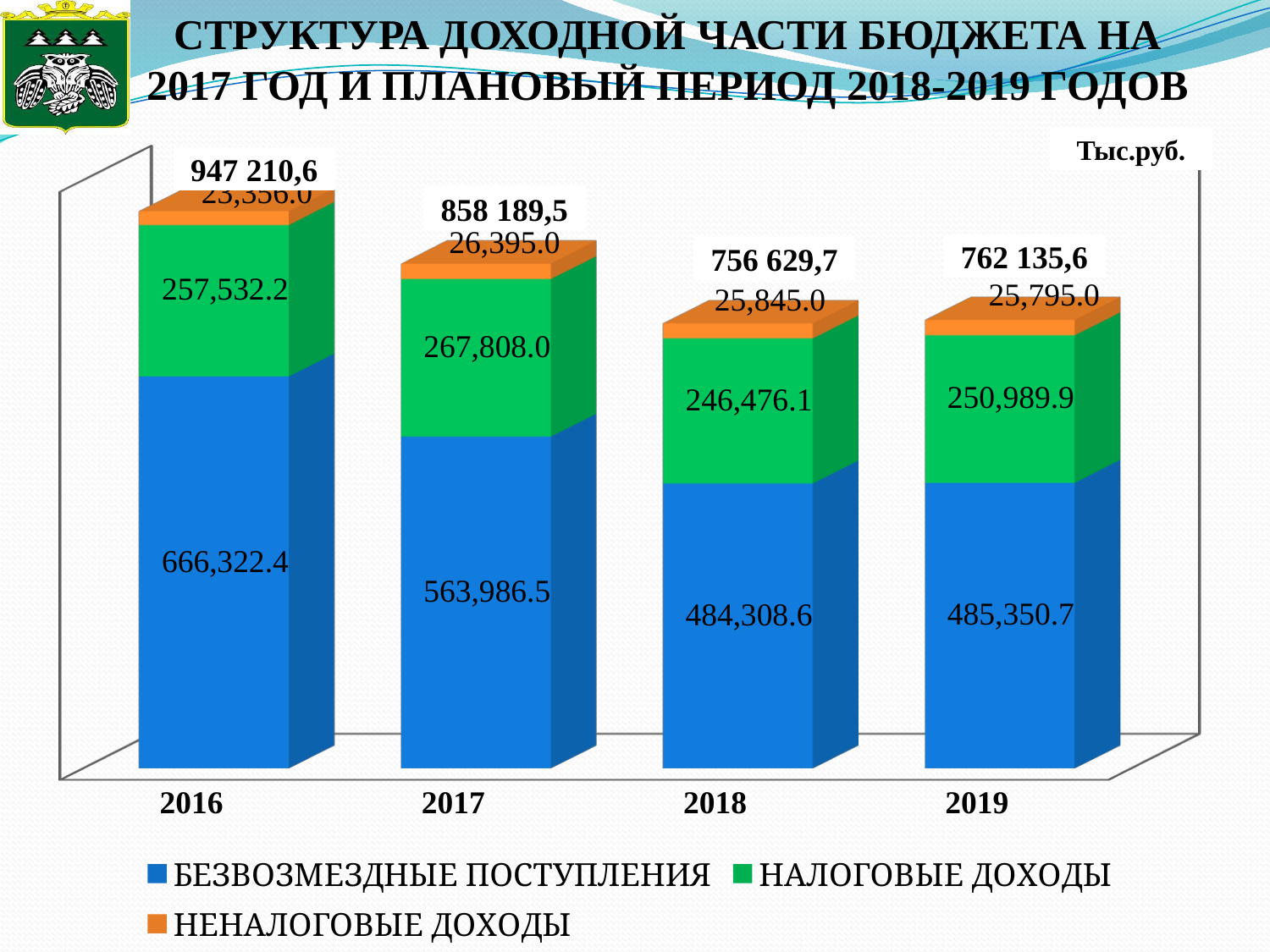
Which year has the lowest value of НАЛОГОВЫЕ ДОХОДЫ? 2018 What is the value of НАЛОГОВЫЕ ДОХОДЫ for 2017? 267,808.0 What is the total shown above the bar for 2018? 756 629,7 Which is larger: НЕНАЛОГОВЫЕ ДОХОДЫ in 2017 or in 2018? 2017 How many years are shown on the x axis? 4 What is the value of БЕЗВОЗМЕЗДНЫЕ ПОСТУПЛЕНИЯ for 2018? 484,308.6 How many series does the legend list? 3 What is the difference between БЕЗВОЗМЕЗДНЫЕ ПОСТУПЛЕНИЯ in 2016 and in 2017? 102,335.9 What is the total shown above the bar for 2016? 947 210,6 Which year has the highest value of БЕЗВОЗМЕЗДНЫЕ ПОСТУПЛЕНИЯ? 2016 What is the value of НЕНАЛОГОВЫЕ ДОХОДЫ for 2019? 25,795.0 What kind of chart is shown on the slide? Stacked bar chart